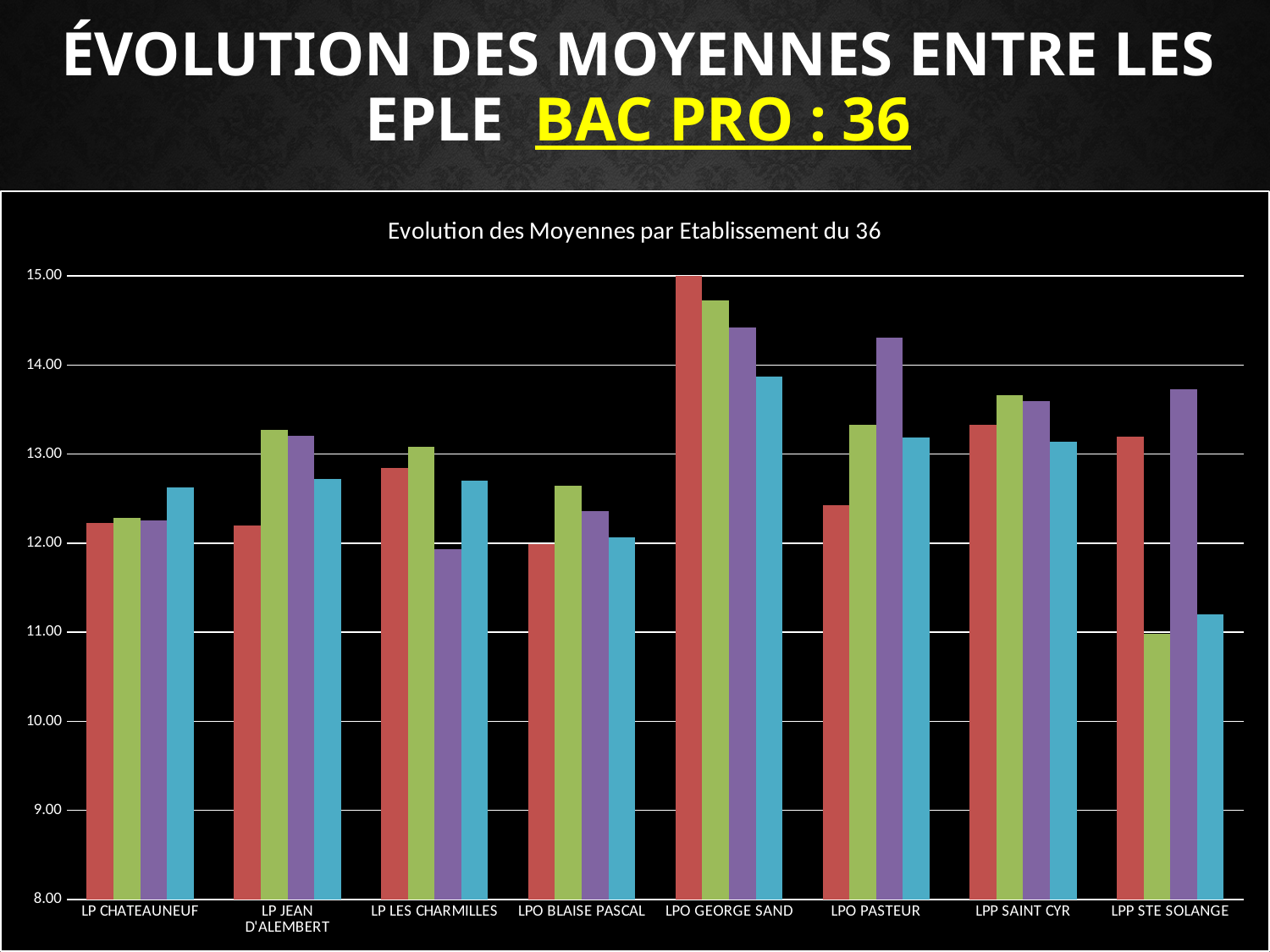
Which establishment has the lowest green bar? LPP STE SOLANGE How many establishments (categories) are shown on the x axis of the chart? 8 What kind of chart is shown on the slide? Bar chart Is the green bar for LPO PASTEUR greater or less than 13.00? greater Is the green bar for LPP STE SOLANGE greater or less than 12.00? less Is the red bar for LPO GEORGE SAND greater or less than 14.00? greater Which establishment has the lowest blue bar? LPP STE SOLANGE Which establishment has the highest red bar? LPO GEORGE SAND What is the title of the chart? Evolution des Moyennes par Etablissement du 36 Which is larger: the green bar for LP JEAN D'ALEMBERT or the green bar for LP CHATEAUNEUF? LP JEAN D'ALEMBERT How many bars are plotted for each establishment in the chart? 4